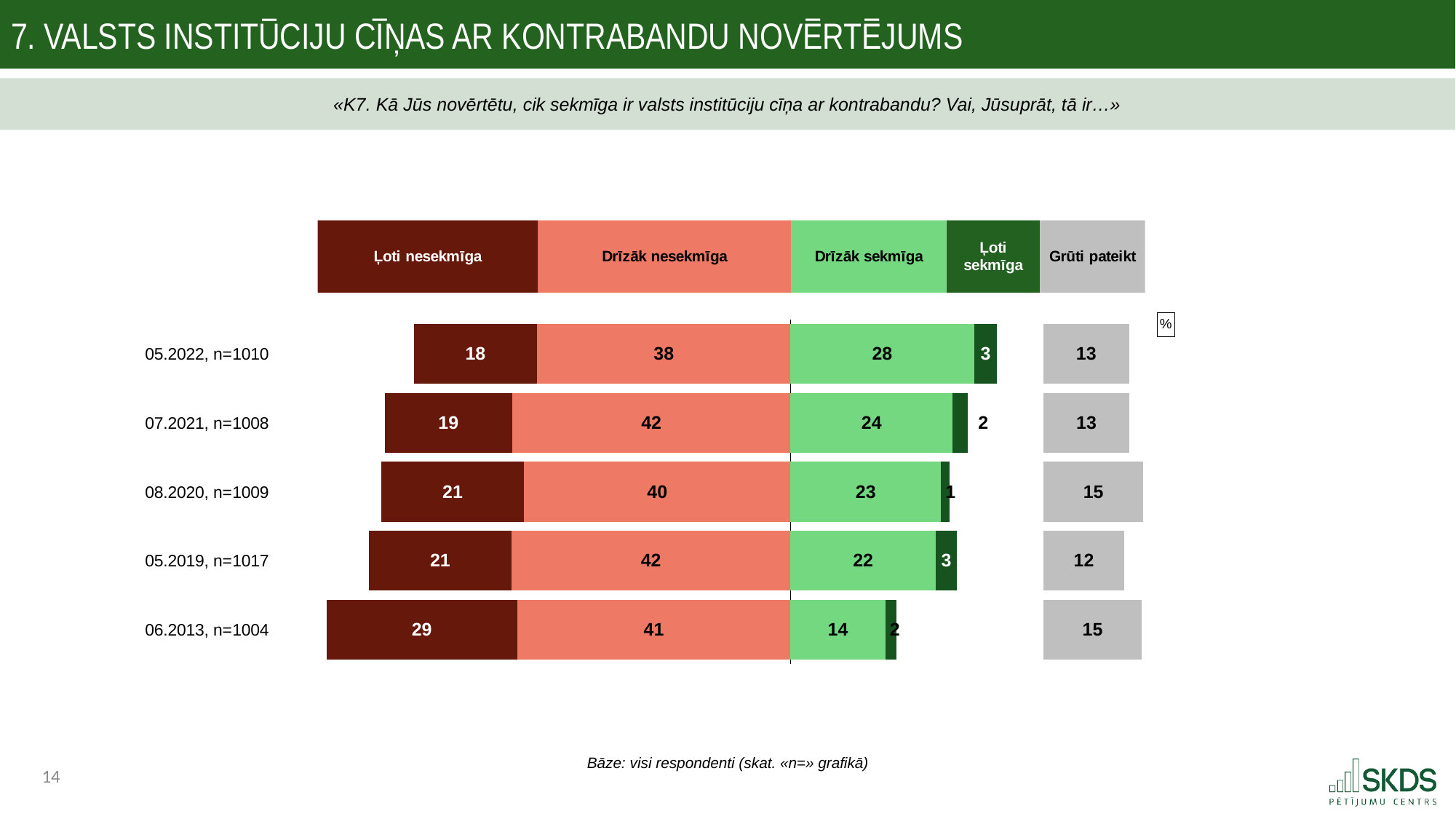
How many response categories does the legend list? 5 Which survey wave has the lowest value for "Ļoti nesekmīga"? 05.2022, n=1010 How many survey waves (rows) are shown in the chart? 5 What is the value for "Grūti pateikt" in the 08.2020, n=1009 row? 15 Going from 06.2013 to 05.2022, does the "Ļoti nesekmīga" value rise or fall? Fall What is the value for "Drīzāk nesekmīga" in the 05.2022, n=1010 row? 38 Which is larger: the "Ļoti nesekmīga" value for 06.2013, n=1004 or for 05.2022, n=1010? 06.2013, n=1004 What is the combined value of "Ļoti nesekmīga" and "Drīzāk nesekmīga" for 05.2022, n=1010? 56 What is the difference between the "Drīzāk sekmīga" values for 05.2022, n=1010 and 06.2013, n=1004? 14 Which survey wave has the highest value for "Drīzāk sekmīga"? 05.2022, n=1010 What is the value for "Ļoti sekmīga" in the 05.2019, n=1017 row? 3 What kind of chart is shown on the slide? Stacked bar chart